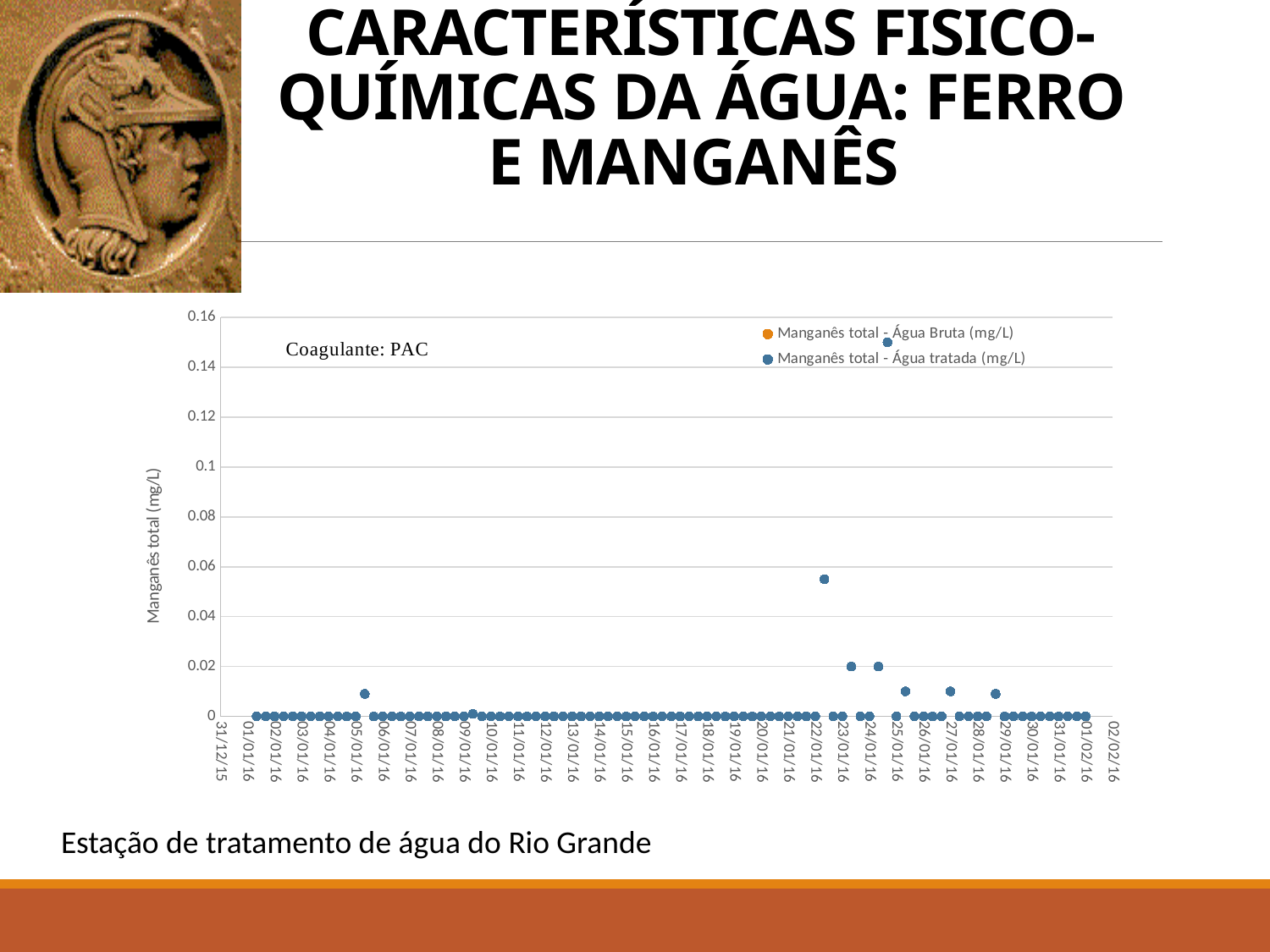
What coagulant is named in the annotation inside the chart? Coagulante: PAC Is the plotted value near 22/01/16 greater or less than 0.06? less Is the plotted value near 22/01/16 greater or less than the value on 15/01/16? greater Is the highest plotted value in the chart greater or less than 0.14? greater What kind of chart is shown on the slide? Scatter chart Is the plotted value near 22/01/16 greater or less than 0.04? greater What is the highest tick value shown on the vertical axis of the chart? 0.16 What is the label of the vertical axis of the chart? Manganês total (mg/L) How many series does the chart legend list? 2